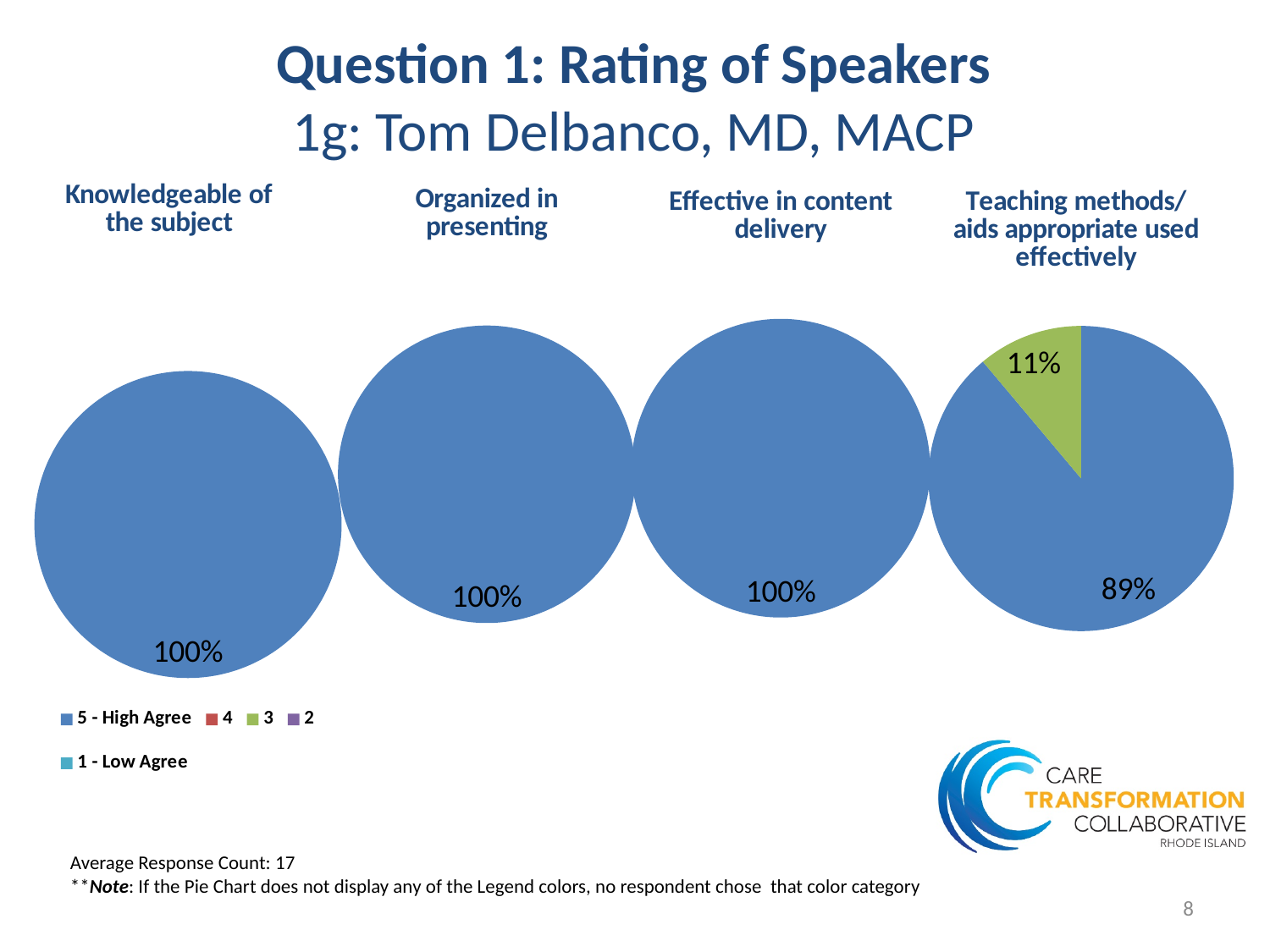
In the 'Teaching methods/aids appropriate used effectively' pie chart, which slice is the largest? 5 - High Agree How many entries does the legend list? 5 What kind of chart is used on this slide? Pie chart In the 'Teaching methods/aids appropriate used effectively' pie chart, what share does the '3' slice have? 11% In the 'Teaching methods/aids appropriate used effectively' pie chart, what share does the '5 - High Agree' slice have? 89% In the 'Knowledgeable of the subject' pie chart, what share is labelled on the slice? 100% In the 'Teaching methods/aids appropriate used effectively' pie chart, what is the difference between the '5 - High Agree' slice and the '3' slice? 78% What is the average response count stated on the slide? 17 In the 'Organized in presenting' pie chart, what percentage is shown? 100% Which pie chart is the only one that shows a slice other than '5 - High Agree'? Teaching methods/aids appropriate used effectively How many pie charts are shown on the slide? 4 In the 'Effective in content delivery' pie chart, what percentage is shown? 100%